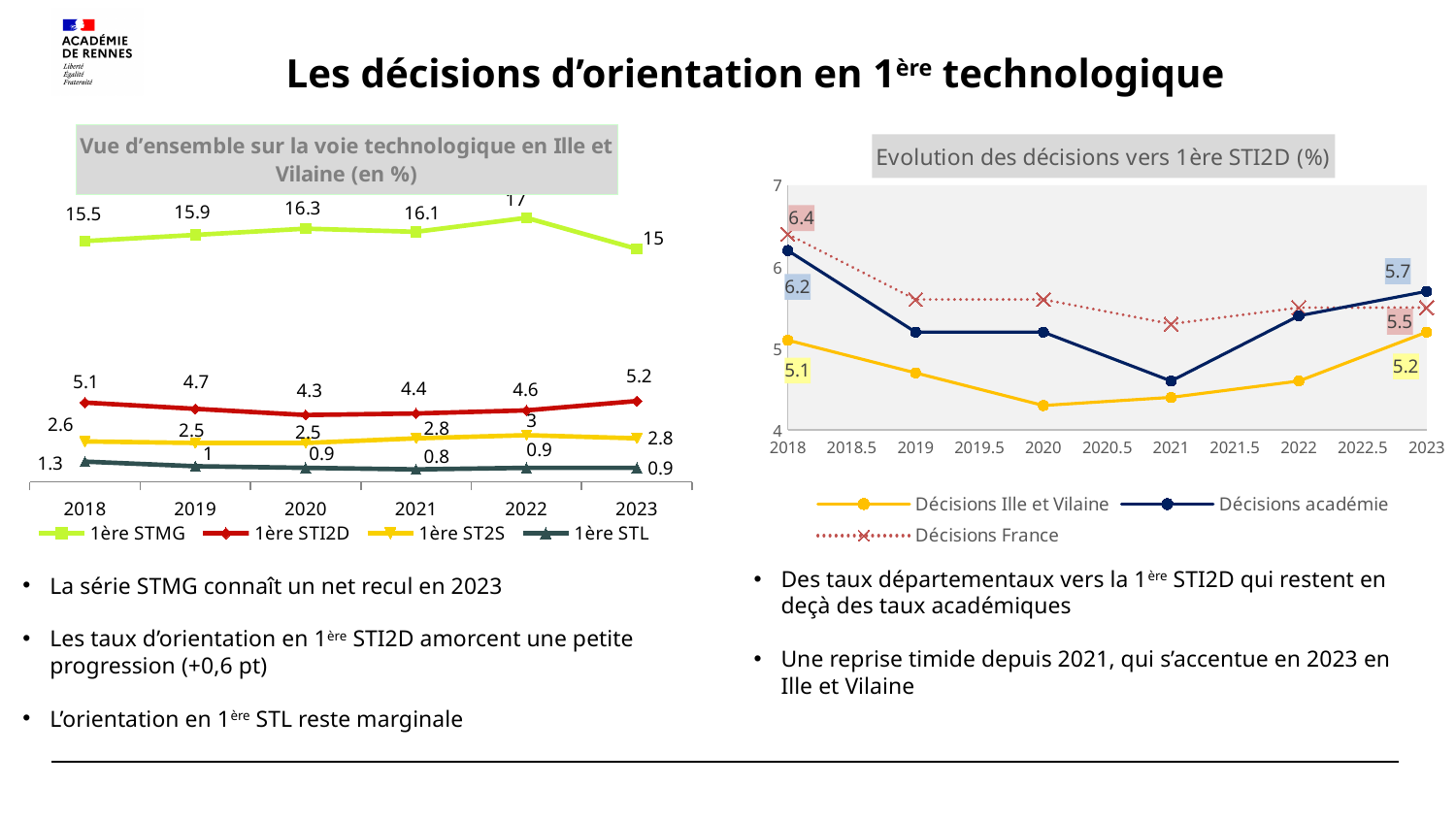
In the chart 'Evolution des décisions vers 1ère STI2D (%)', what is the value for Décisions France in 2018? 6.4 In the chart 'Evolution des décisions vers 1ère STI2D (%)', is the value for Décisions Ille et Vilaine in 2020 greater or less than 5? less In the chart 'Vue d'ensemble sur la voie technologique en Ille et Vilaine (en %)', how many series does the legend list? 4 In the chart 'Vue d'ensemble sur la voie technologique en Ille et Vilaine (en %)', what is the value for 1ère STI2D in 2023? 5.2 In the chart 'Vue d'ensemble sur la voie technologique en Ille et Vilaine (en %)', in which year is 1ère STMG highest? 2022 In the chart 'Vue d'ensemble sur la voie technologique en Ille et Vilaine (en %)', in which year is 1ère STL lowest? 2021 In the chart 'Evolution des décisions vers 1ère STI2D (%)', what is the value for Décisions académie in 2023? 5.7 In the chart 'Vue d'ensemble sur la voie technologique en Ille et Vilaine (en %)', what is the difference between the 1ère STMG values for 2022 and 2023? 2 In the chart 'Vue d'ensemble sur la voie technologique en Ille et Vilaine (en %)', what is the value for 1ère STMG in 2020? 16.3 In the chart 'Vue d'ensemble sur la voie technologique en Ille et Vilaine (en %)', how many years are shown on the x axis? 6 In the chart 'Vue d'ensemble sur la voie technologique en Ille et Vilaine (en %)', which is larger in 2022: 1ère ST2S or 1ère STL? 1ère ST2S What kind of chart is 'Evolution des décisions vers 1ère STI2D (%)'? line chart